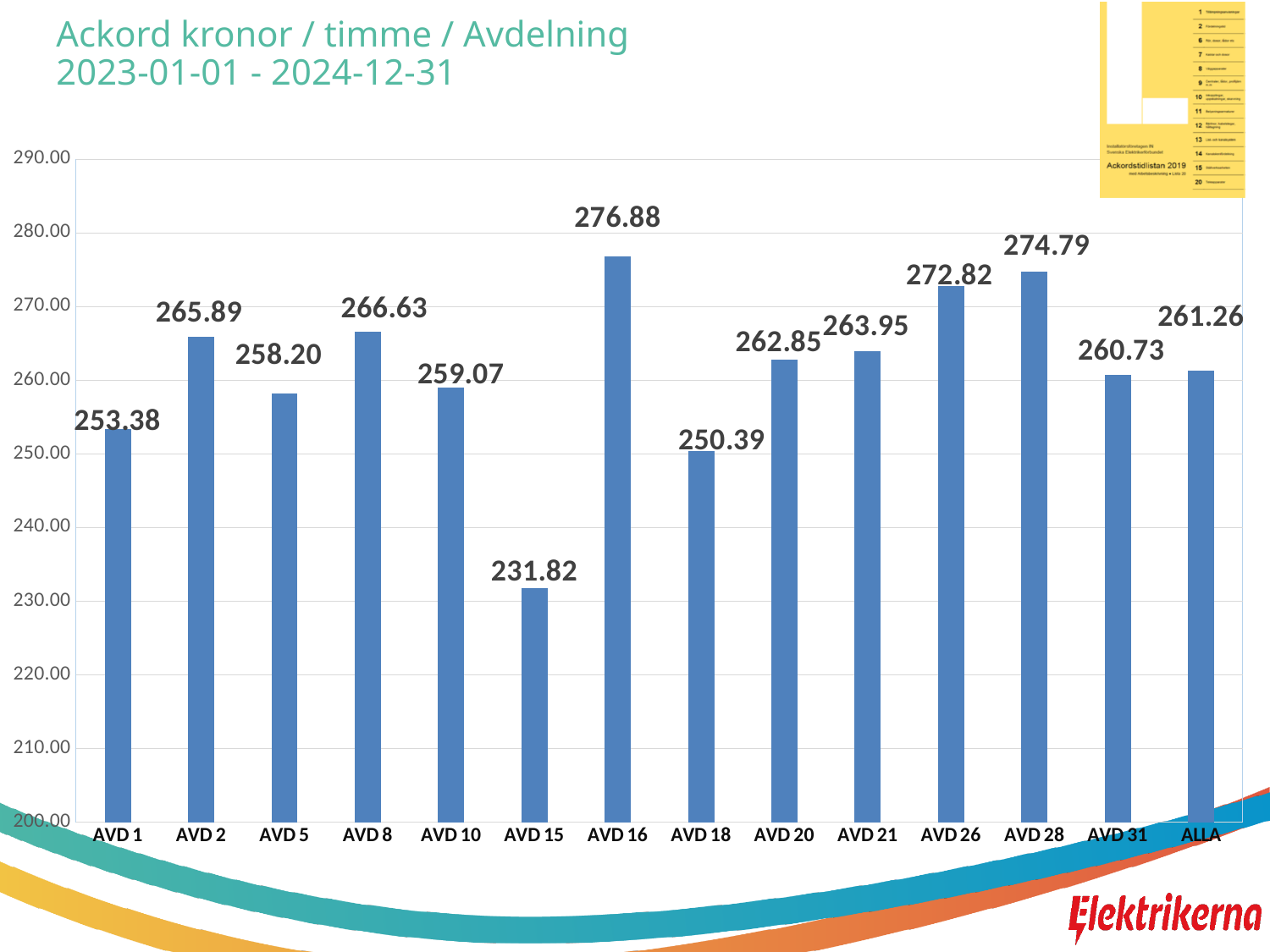
Which category has the lowest value? AVD 15 What is the value for AVD 16? 276.88 Is the value for AVD 18 greater or less than 260.00? less What is the value for AVD 21? 263.95 What is the difference between the values for AVD 16 and AVD 15? 45.06 What kind of chart is shown on the slide? bar chart What is the value for ALLA? 261.26 Which category has the highest value? AVD 16 What is the value for AVD 15? 231.82 What is the difference between the values for AVD 28 and AVD 26? 1.97 Which is larger, the value for AVD 2 or the value for AVD 8? AVD 8 How many categories are shown on the x axis? 14